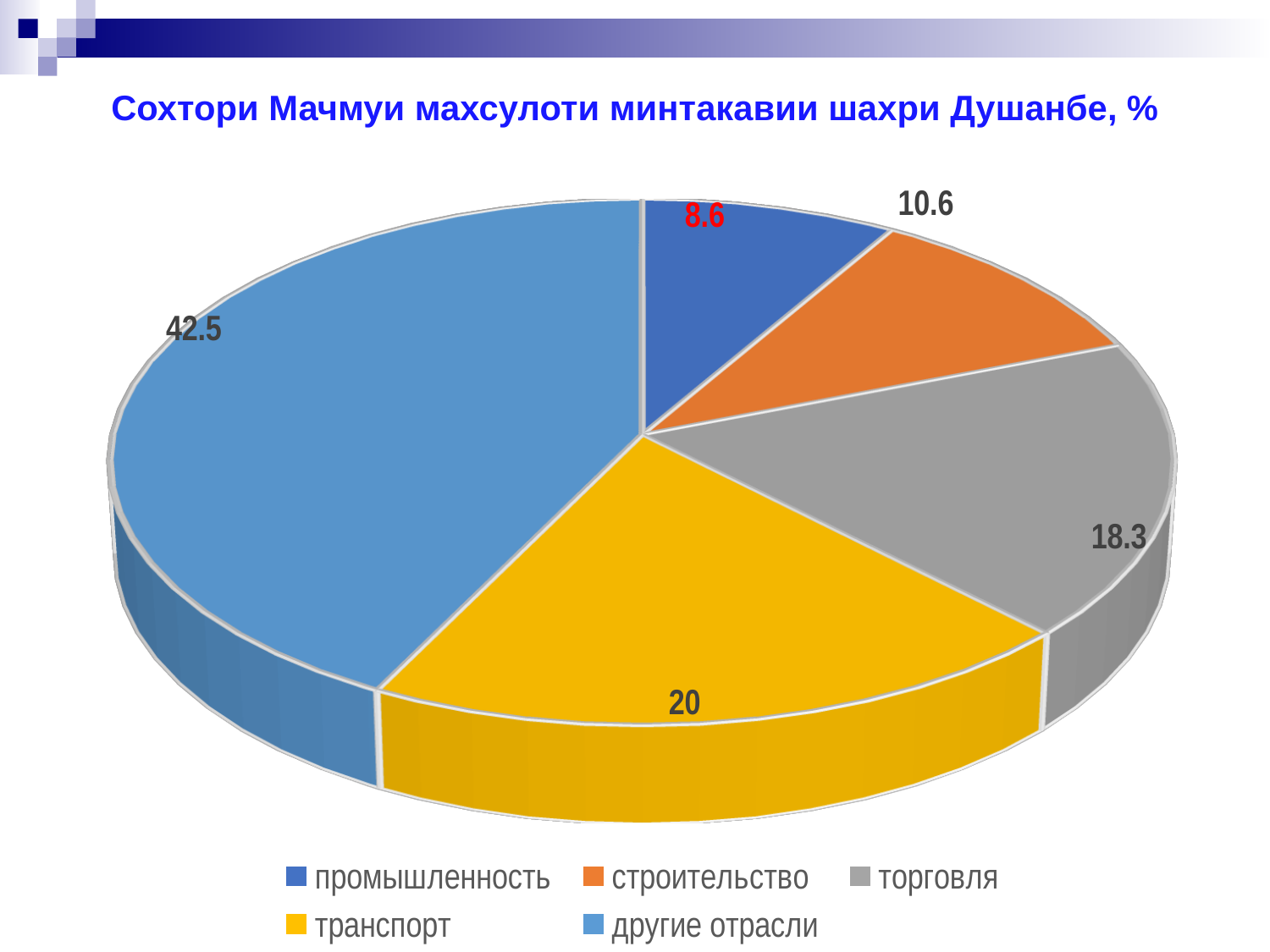
What is the value for транспорт? 20 Which is larger, торговля or строительство? торговля What is the title of the chart? Сохтори Мачмуи махсулоти минтакавии шахри Душанбе, % How many categories does the pie chart have? 5 Which category has the largest slice? другие отрасли Which category has the smallest slice? промышленность What is the value for строительство? 10.6 What is the value for торговля? 18.3 What is the value for другие отрасли? 42.5 What is the difference between the values for другие отрасли and транспорт? 22.5 What is the value for промышленность? 8.6 What type of chart is shown on the slide? pie chart